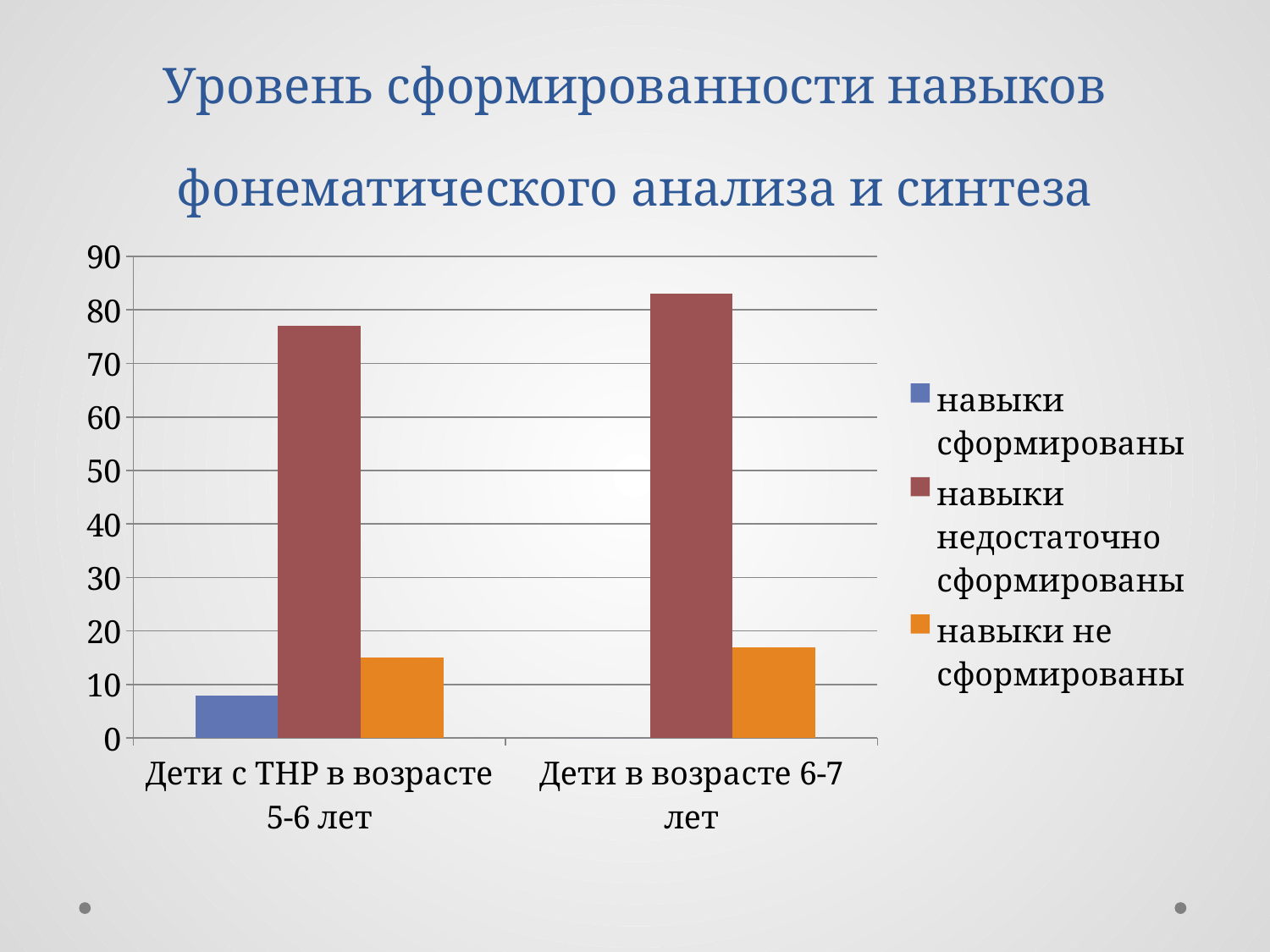
Is the value of "навыки не сформированы" for "Дети в возрасте 6-7 лет" greater or less than 20? less Which series has the highest value for "Дети в возрасте 6-7 лет"? навыки недостаточно сформированы What colour are the bars for the series "навыки не сформированы"? orange Is the value of "навыки недостаточно сформированы" for "Дети в возрасте 6-7 лет" greater or less than 80? greater Is the value of "навыки сформированы" for "Дети с ТНР в возрасте 5-6 лет" greater or less than 10? less How many series does the legend list? 3 How many categories are shown on the x axis? 2 Which category has the larger value for "навыки недостаточно сформированы": "Дети с ТНР в возрасте 5-6 лет" or "Дети в возрасте 6-7 лет"? Дети в возрасте 6-7 лет What kind of chart is shown on the slide? bar chart Which series has the highest value for "Дети с ТНР в возрасте 5-6 лет"? навыки недостаточно сформированы Which series has the lowest value for "Дети с ТНР в возрасте 5-6 лет"? навыки сформированы